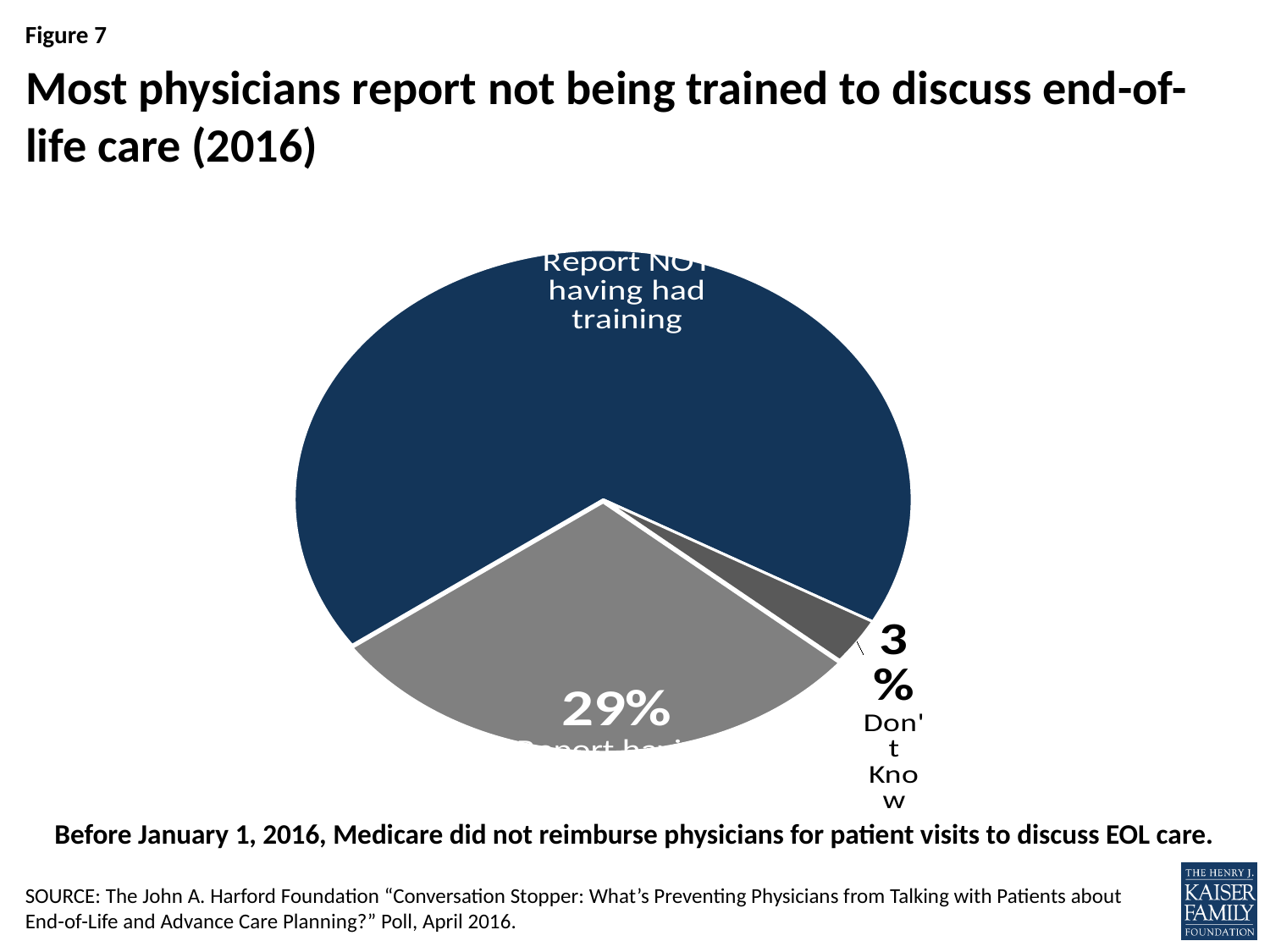
Which slice of the pie chart is the largest? Report NOT having had training What type of chart is shown on the slide? Pie chart Which slice of the pie chart is the smallest? Don't Know What is the difference in percentage points between the "Report having had training" slice (29%) and the "Don't Know" slice (3%)? 26 percentage points Is the "Report NOT having had training" slice larger or smaller than the "Report having had training" slice? Larger What is the title of the chart on the slide? Most physicians report not being trained to discuss end-of-life care (2016) How many slices does the pie chart have? 3 What colour is the "Report NOT having had training" slice of the pie chart? Dark blue What percentage of physicians answered "Don't Know" in the pie chart? 3% Which is larger in the pie chart: the share reporting having had training or the share answering "Don't Know"? Report having had training What percentage of physicians report having had training, according to the pie chart? 29% What share of the pie does the "Don't Know" slice represent? 3%